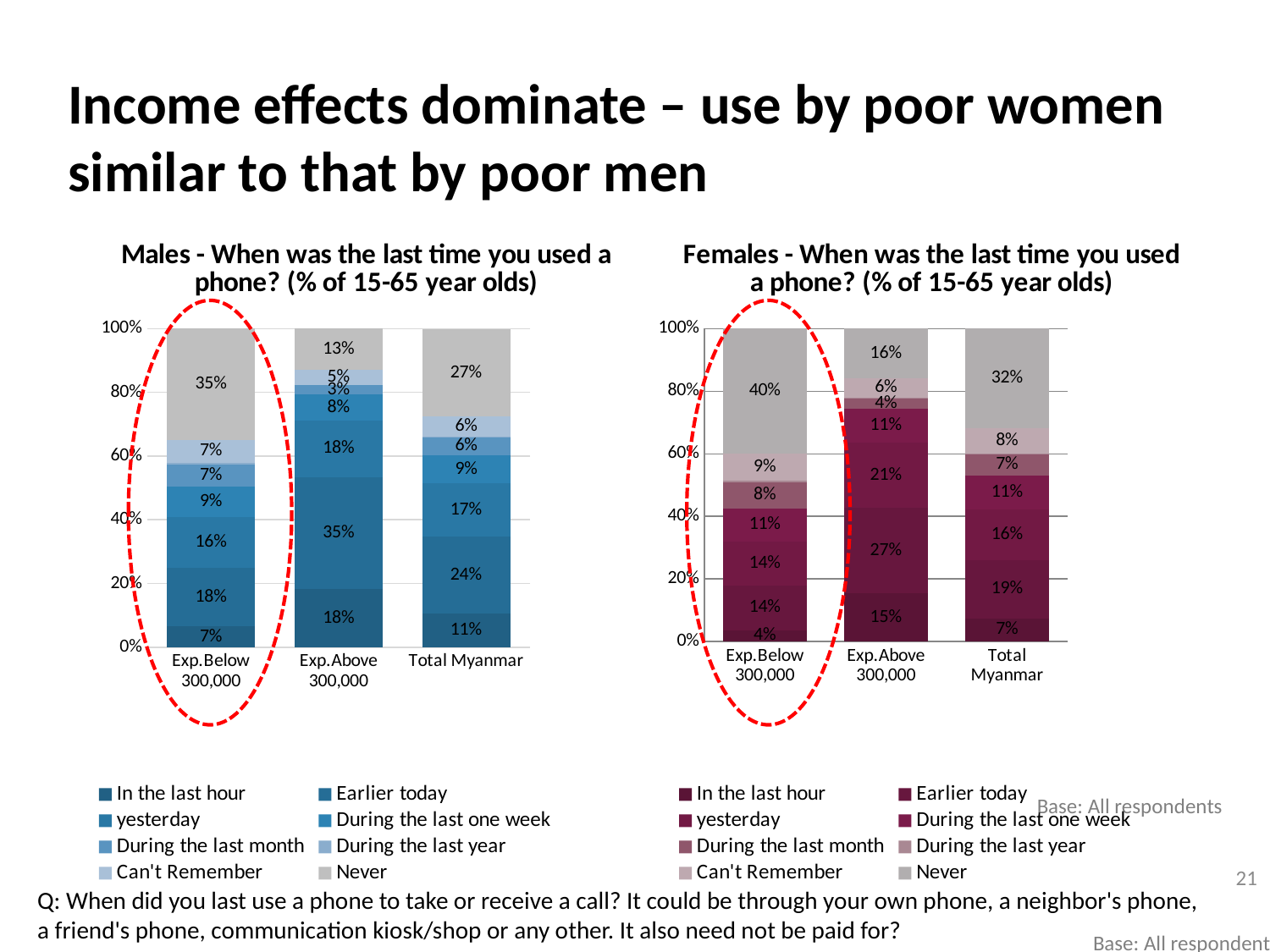
In the Females chart, what is the difference between the 'Never' share for Exp.Below 300,000 and Exp.Above 300,000? 24 percentage points What kind of chart is the Males chart on the left? Stacked bar chart In the Males chart, what is the difference between the 'Never' share for Exp.Below 300,000 and Exp.Above 300,000? 22 percentage points In the Females chart, what percentage of the Exp.Below 300,000 group answered 'Never'? 40% In the Males chart, what is the 'In the last hour' value for Exp.Above 300,000? 18% In the Females chart, which category has the lowest 'In the last hour' share? Exp.Below 300,000 How many categories are shown on the x axis of the Females chart? 3 In the Males chart, what percentage of the Exp.Below 300,000 group answered 'Never'? 35% Which is larger: the 'Never' share for Total Myanmar in the Males chart or in the Females chart? Females chart (32%) In the Females chart, what is the 'In the last hour' value for Exp.Above 300,000? 15% In the Males chart, which category has the highest 'Never' share? Exp.Below 300,000 How many series does the legend of the Males chart list? 8